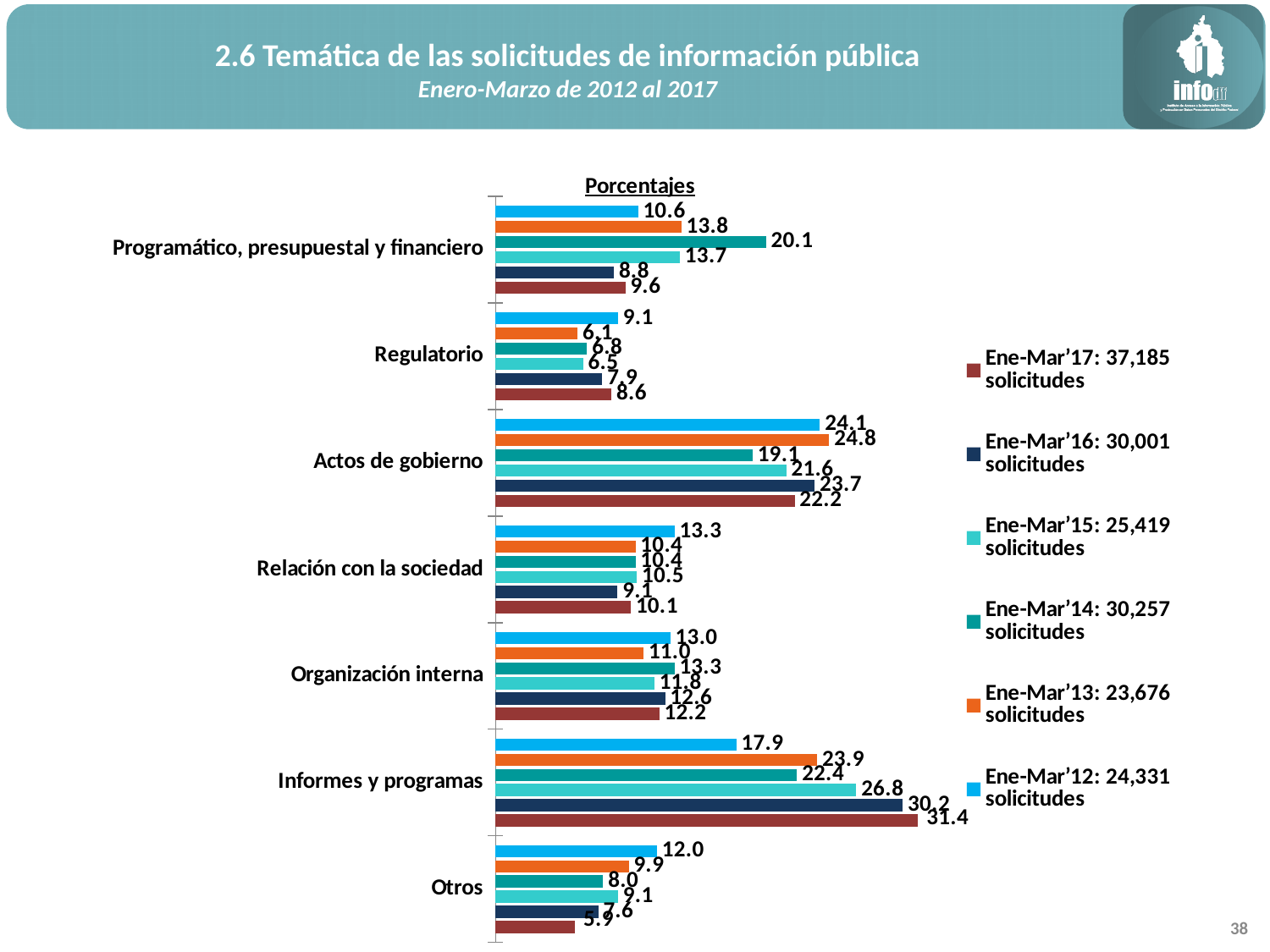
Which category has the lowest value in the Ene-Mar'17 series? Otros What is the value for Otros in the Ene-Mar'12 series? 12.0 How many series does the legend list? 6 How many categories are shown on the chart? 7 According to the legend, how many solicitudes were there in Ene-Mar'17? 37,185 What is the difference between the Ene-Mar'17 and Ene-Mar'12 values for Informes y programas? 13.5 Which category has the highest value in the Ene-Mar'16 series? Informes y programas Which is larger for Regulatorio: the Ene-Mar'12 value or the Ene-Mar'13 value? Ene-Mar'12 What is the value for Informes y programas in the Ene-Mar'17 series? 31.4 What is the value for Actos de gobierno in the Ene-Mar'13 series? 24.8 What kind of chart is shown on the slide? Bar chart What is the value for Programático, presupuestal y financiero in the Ene-Mar'14 series? 20.1